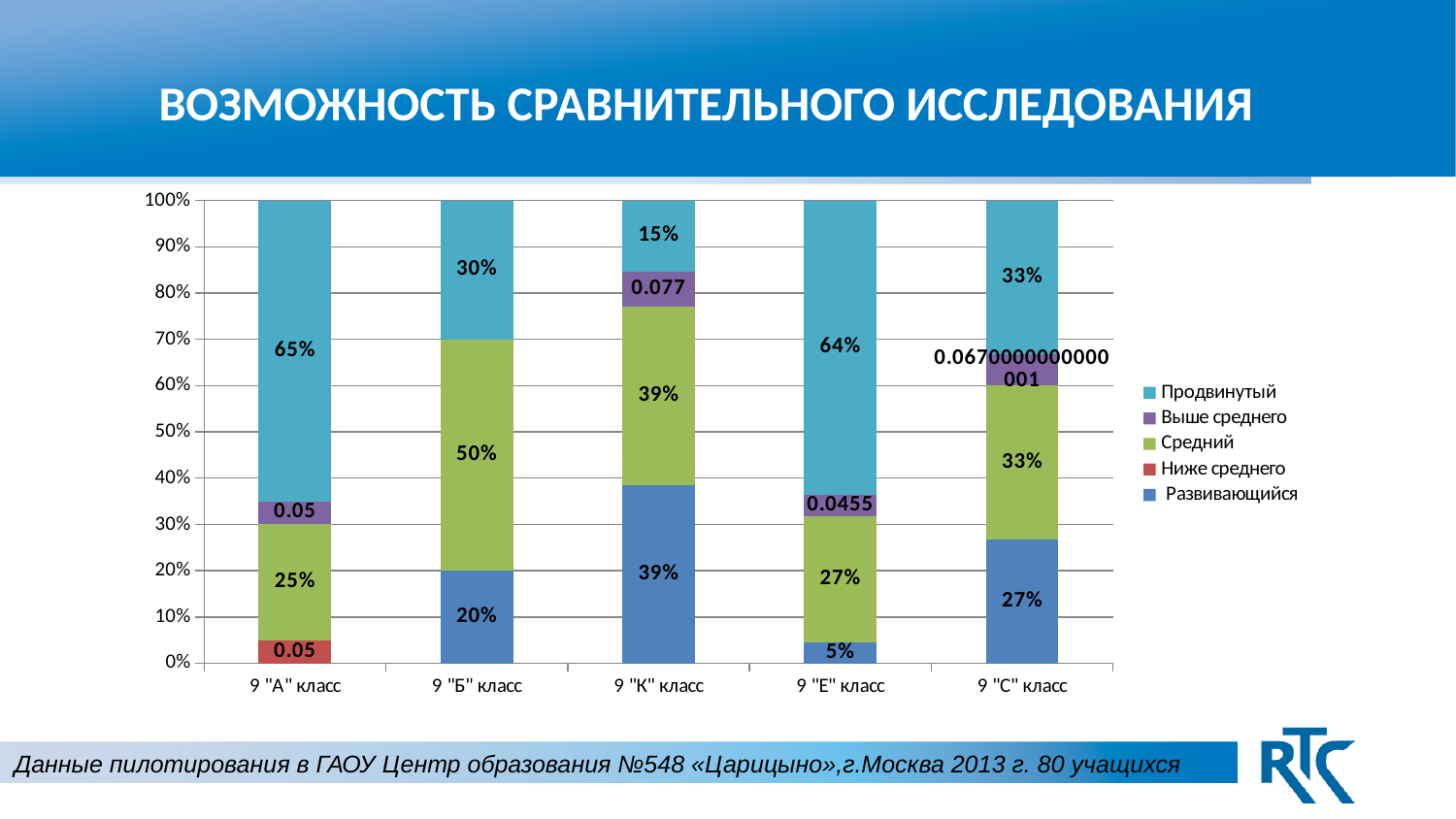
Which class has the highest value for Продвинутый? 9 "А" класс Which series is shown in green in the legend? Средний What is the value of Развивающийся for 9 "К" класс? 39% How many classes (categories) are shown on the x axis? 5 Which is larger: the Развивающийся value for 9 "С" класс or for 9 "Б" класс? 9 "С" класс How many series does the legend list? 5 What is the value of Продвинутый for 9 "А" класс? 65% What is the value of Выше среднего for 9 "Е" класс? 0.0455 What kind of chart is shown on the slide? Stacked bar chart What is the difference between the Средний values for 9 "Б" класс and 9 "А" класс? 25% What is the value of Средний for 9 "Б" класс? 50% Which class has the lowest value for Продвинутый? 9 "К" класс